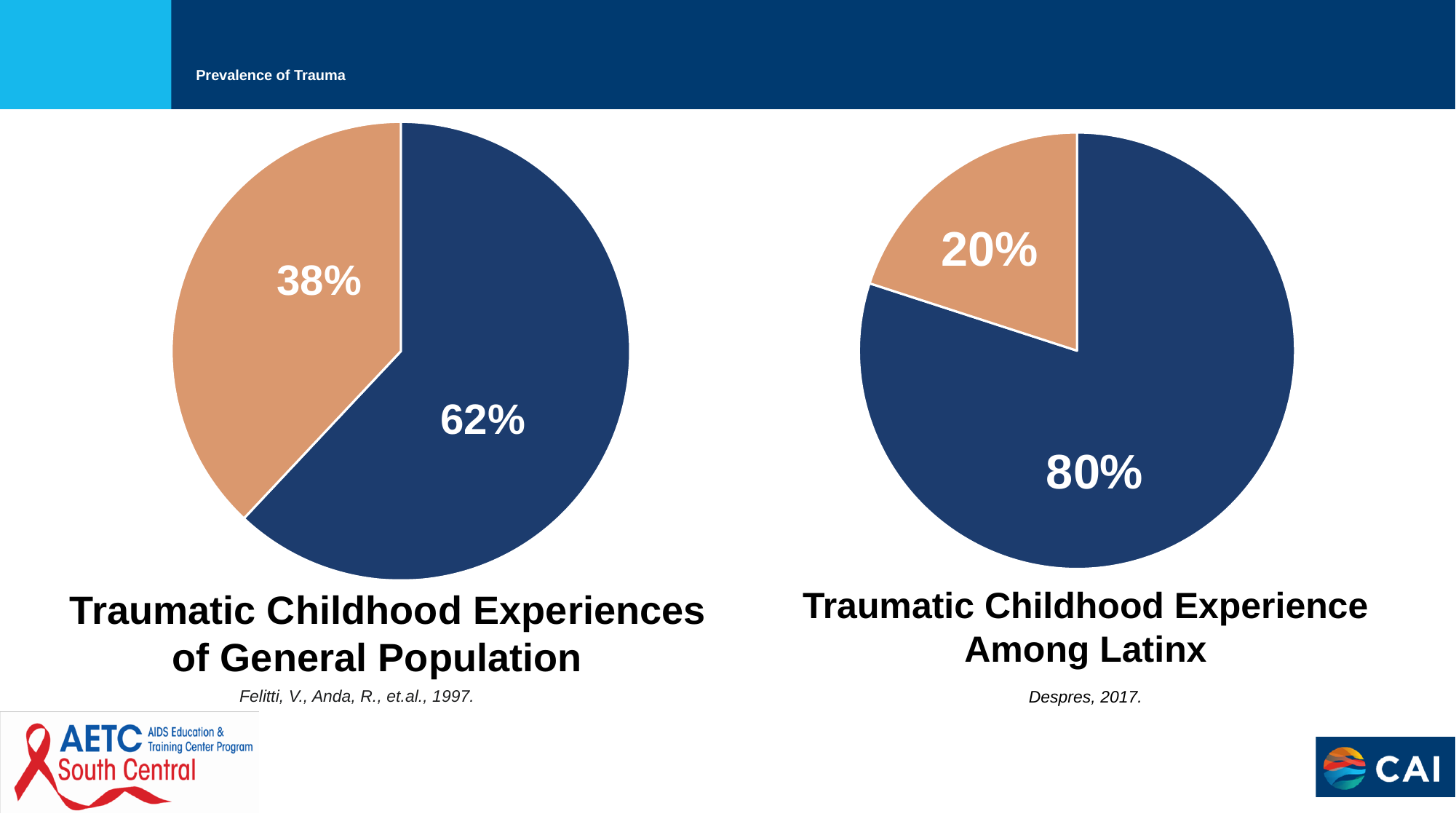
In the 'Traumatic Childhood Experiences of General Population' chart, what percentage is shown on the orange slice? 38% In the 'Traumatic Childhood Experiences of General Population' chart, what is the difference between the dark blue slice and the orange slice? 24% In the 'Traumatic Childhood Experience Among Latinx' chart, what percentage is shown on the orange slice? 20% In the 'Traumatic Childhood Experience Among Latinx' chart, what percentage is shown on the dark blue slice? 80% In the 'Traumatic Childhood Experiences of General Population' chart, which slice is the largest? the dark blue slice (62%) How many pie charts are shown on the slide? 2 In the 'Traumatic Childhood Experience Among Latinx' chart, what is the difference between the dark blue slice and the orange slice? 60% How many slices does the 'Traumatic Childhood Experience Among Latinx' pie chart have? 2 In the 'Traumatic Childhood Experience Among Latinx' chart, which slice is the smallest? the orange slice (20%) In the 'Traumatic Childhood Experiences of General Population' chart, what percentage is shown on the dark blue slice? 62% What kind of chart is the 'Traumatic Childhood Experiences of General Population' chart? pie chart Which is larger: the dark blue slice in the 'Traumatic Childhood Experiences of General Population' chart or the dark blue slice in the 'Traumatic Childhood Experience Among Latinx' chart? the dark blue slice in the 'Traumatic Childhood Experience Among Latinx' chart (80%)